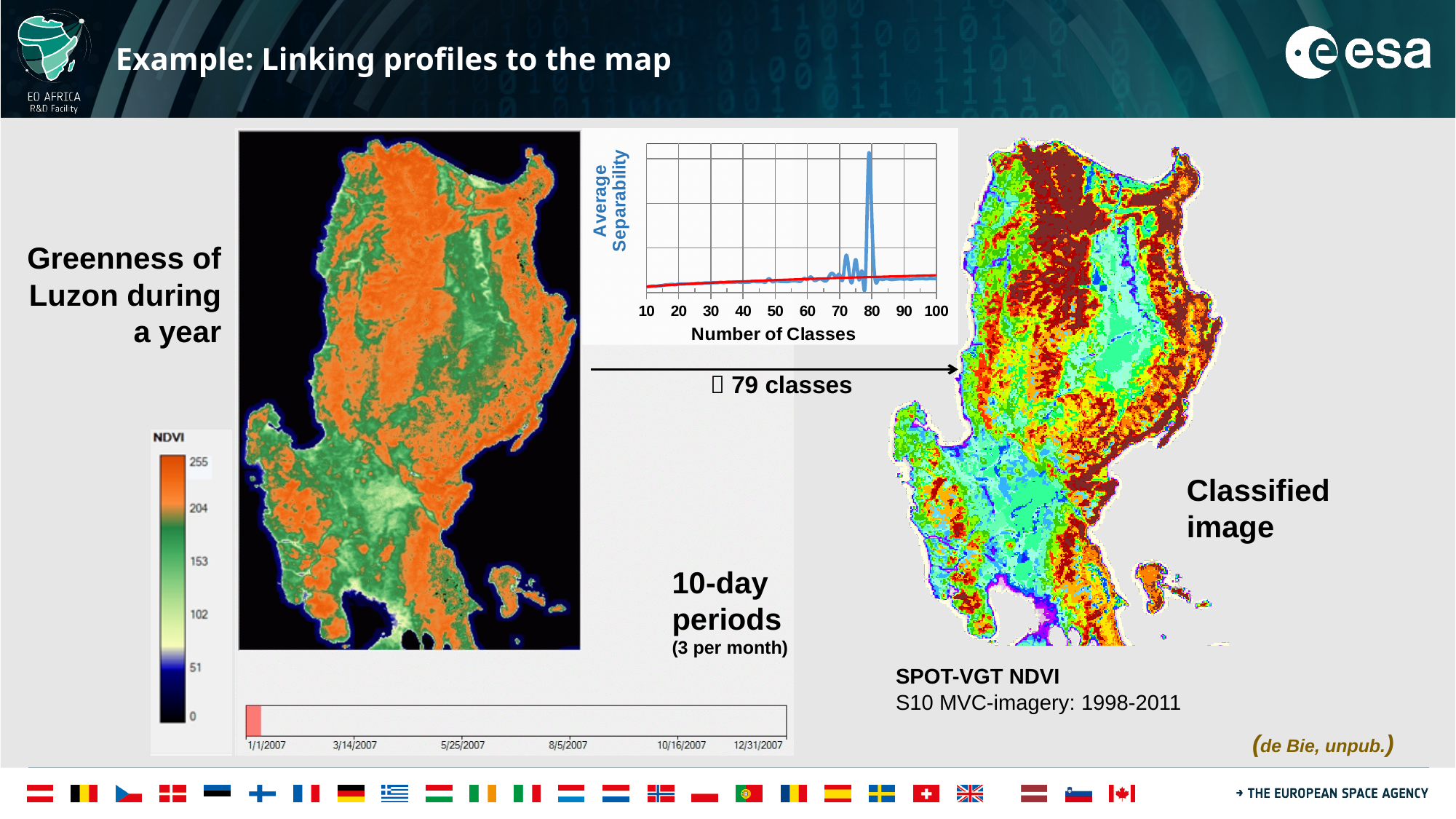
Between which two x-axis ticks does the blue line in the Average Separability chart reach its sharp peak? 70 and 80 How many lines are plotted in the Average Separability chart? 2 What is the label of the x axis of the line chart? Number of Classes What kind of chart is the Average Separability versus Number of Classes chart? line chart What is the label of the y axis of the line chart? Average Separability What is the highest tick value on the x axis of the line chart? 100 Is the peak of the blue line in the Average Separability chart at a number of classes greater or less than 50? greater Does the red line in the Average Separability chart rise or fall as the number of classes increases? rise What is the lowest tick value on the x axis of the line chart? 10 How many tick labels are shown on the x axis of the line chart? 10